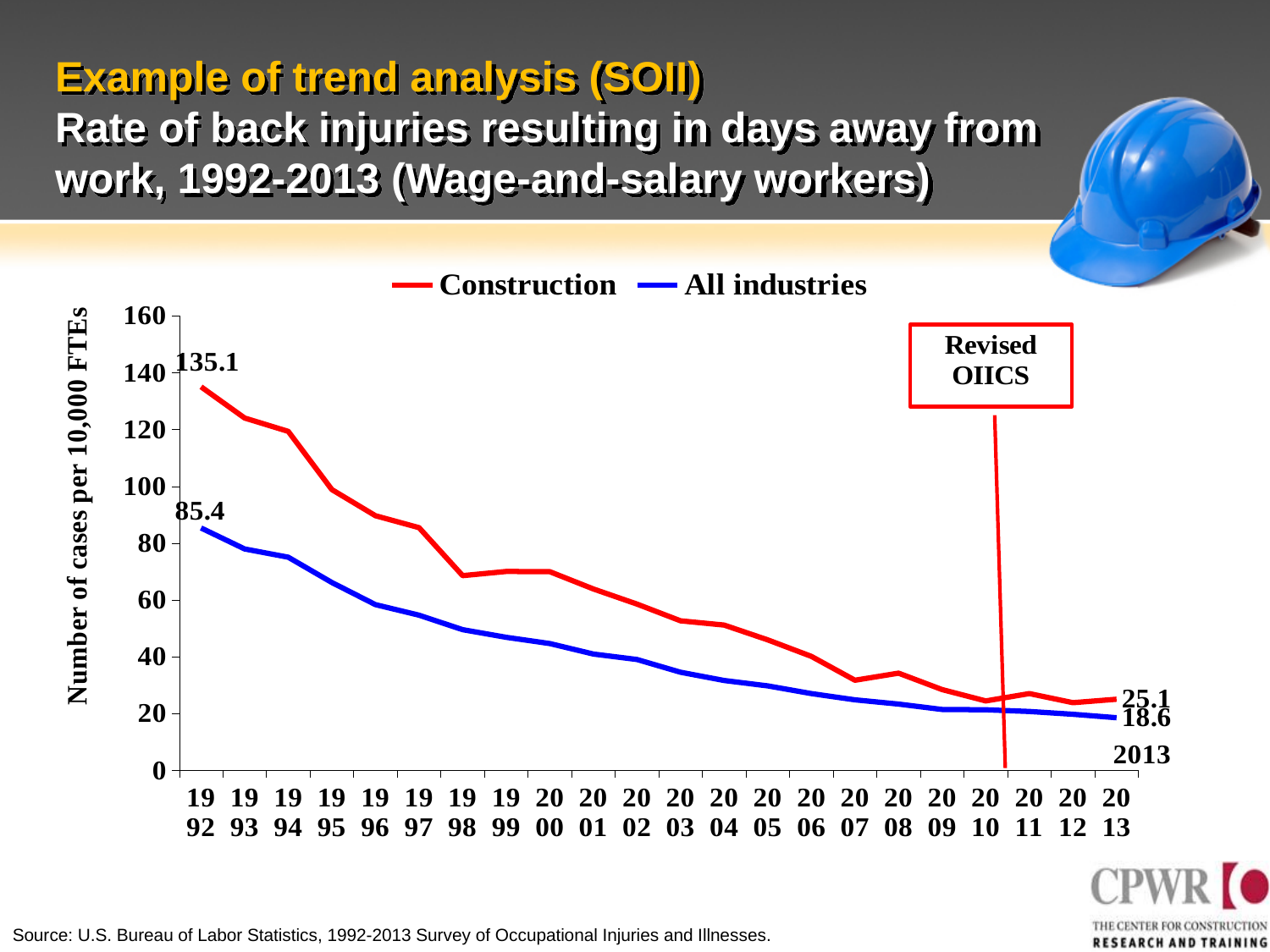
What is the difference between the Construction and All industries rates in 1992? 49.7 Do the Construction rates rise or fall from 1992 to 2013? Fall How many series does the legend list? 2 What is the All industries rate in 1992? 85.4 What is the Construction rate in 1992? 135.1 What kind of chart is shown on the slide? Line chart Is the All industries rate in 2005 greater or less than 40? less What is the Construction rate in 2013? 25.1 What is the difference between the Construction and All industries rates in 2013? 6.5 Is the Construction rate in 2000 greater or less than 60? greater Which series has the higher rate in 1992, Construction or All industries? Construction What is the All industries rate in 2013? 18.6